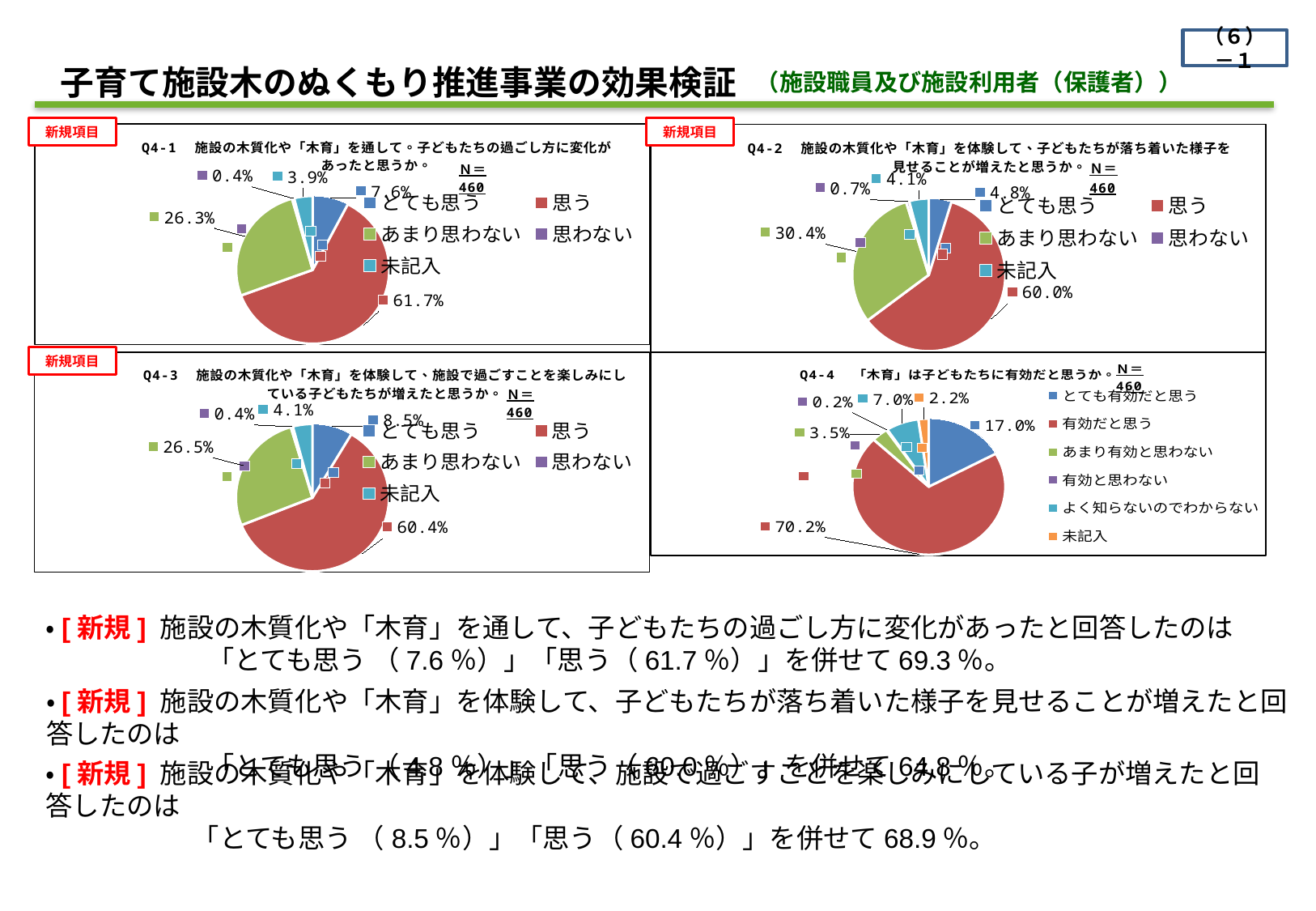
In the Q4-1 chart (top left), what percentage is shown for 「あまり思わない」? 26.3% In the Q4-2 chart (top right), which category has the largest share? 思う In the Q4-2 chart (top right), which category has the smallest share? 思わない In the Q4-1 chart (top left), what percentage is shown for 「思う」? 61.7% What is the N value shown for the Q4-1 chart? N＝460 In the Q4-4 chart (bottom right), how many categories does the legend list? 6 In the Q4-3 chart (bottom left), which is larger: 「未記入」 or 「とても思う」? とても思う In the Q4-3 chart (bottom left), what percentage is shown for 「とても思う」? 8.5% In the Q4-4 chart (bottom right), what percentage is shown for 「有効だと思う」? 70.2% In the Q4-2 chart (top right), what is the difference between 「思う」 and 「あまり思わない」? 29.6% What type of chart is used for Q4-1? Pie chart In the Q4-4 chart (bottom right), what is the difference between 「よく知らないのでわからない」 and 「あまり有効と思わない」? 3.5%